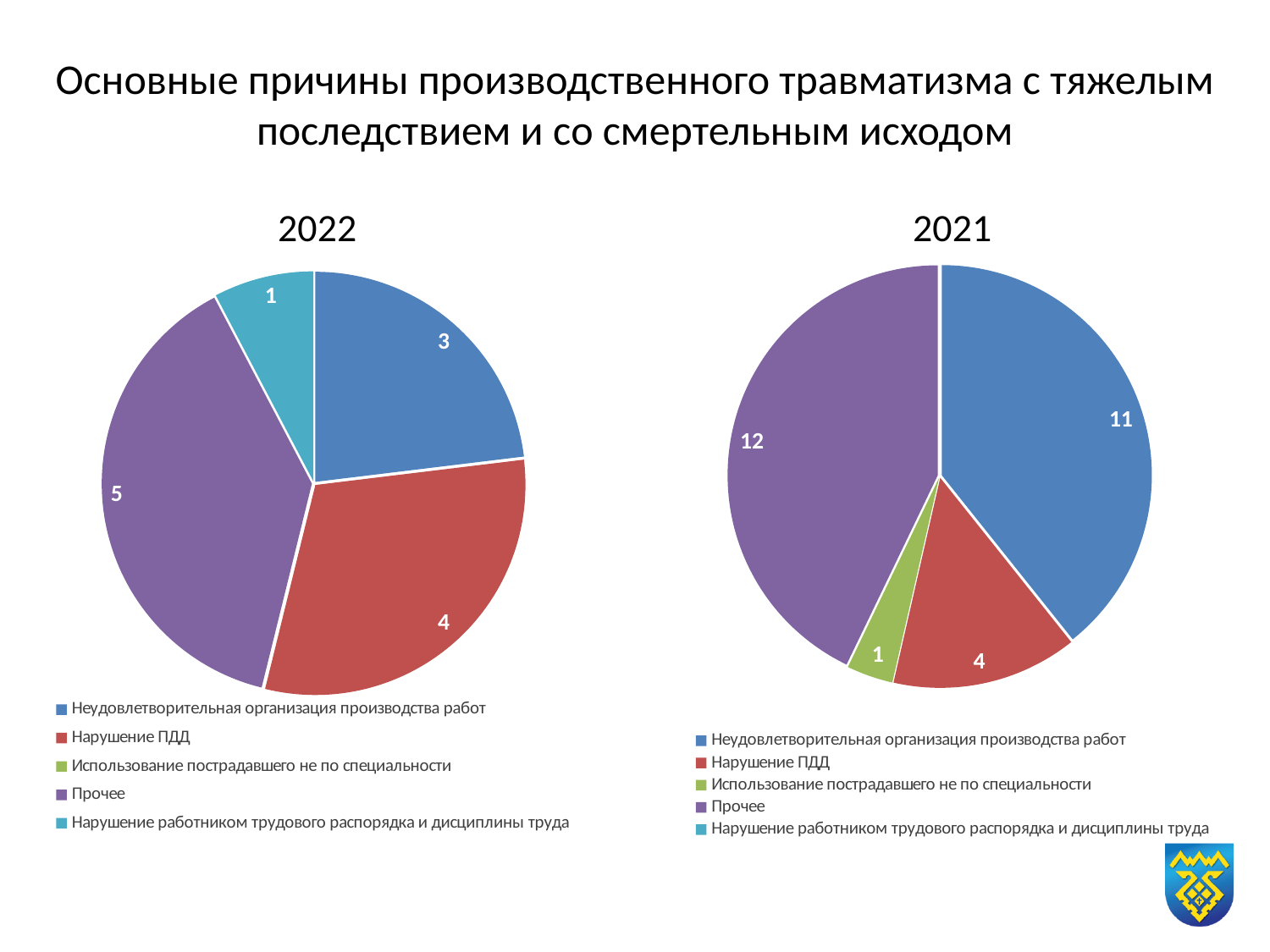
In the 2021 pie chart, which category has the smallest slice? Использование пострадавшего не по специальности In the 2021 pie chart, what is the value for Использование пострадавшего не по специальности? 1 How many entries does the legend of the 2022 chart list? 5 In the 2022 pie chart, which category has the largest slice? Прочее In the 2021 pie chart, what is the value for Неудовлетворительная организация производства работ? 11 In the 2022 pie chart, which is larger: Неудовлетворительная организация производства работ or Нарушение ПДД? Нарушение ПДД How many slices are shown in the 2021 pie chart? 4 In the 2022 pie chart, what is the value for Прочее? 5 In the 2022 pie chart, which category has the smallest slice? Нарушение работником трудового распорядка и дисциплины труда What type of chart is used for the 2022 data? Pie chart In the 2022 pie chart, what is the value for Нарушение ПДД? 4 In the 2021 pie chart, what is the difference between the values for Прочее and Нарушение ПДД? 8